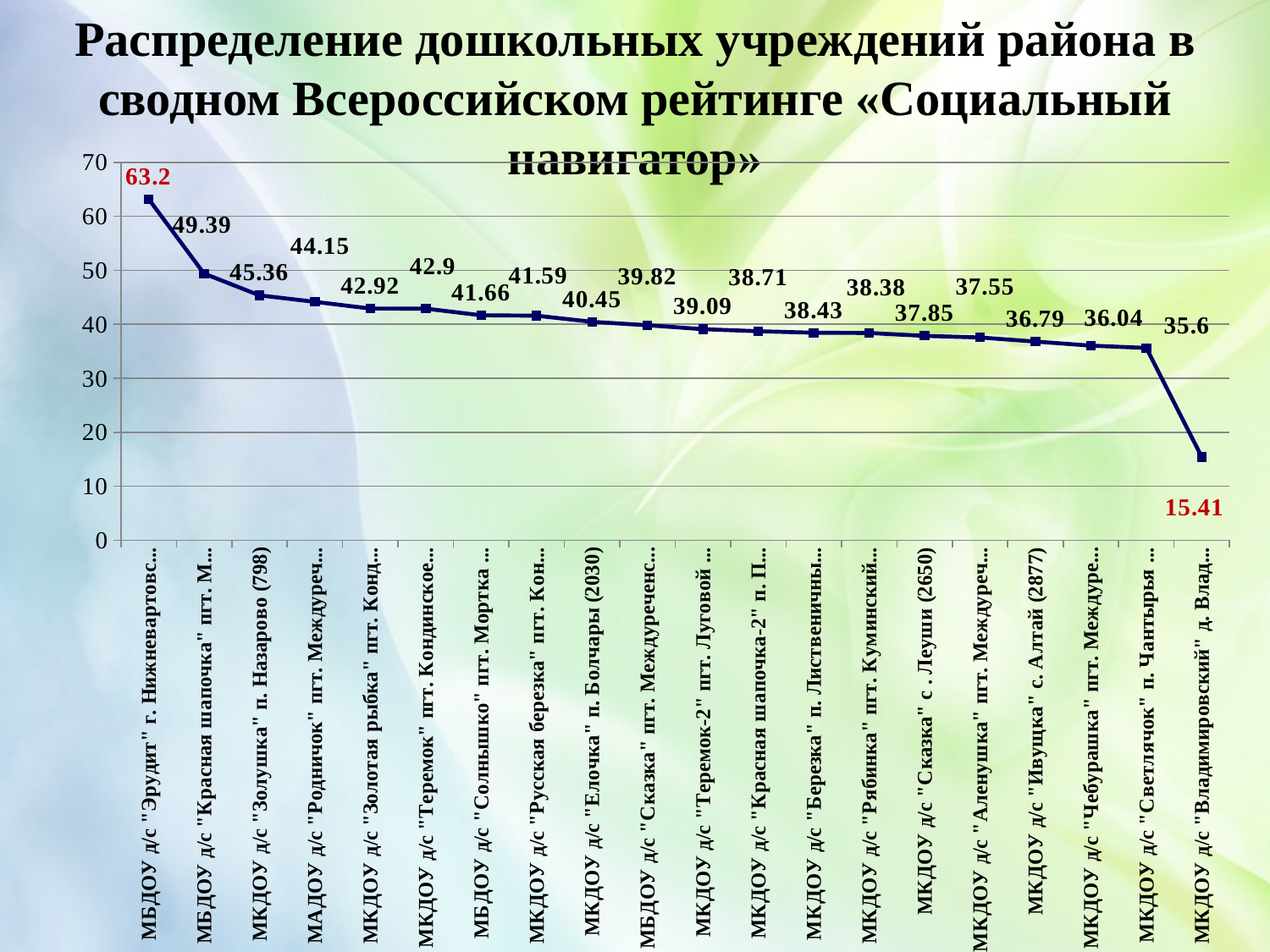
Which has a larger value: МКДОУ д/с "Золушка" п. Назарово (798) or МКДОУ д/с "Ивушка" с. Алтай (2877)? МКДОУ д/с "Золушка" п. Назарово (798) Which institution has the lowest value on the chart? МКДОУ д/с "Владимировский" What type of chart is shown on the slide? line chart How many institutions are plotted on the chart? 20 Which institution has the highest value on the chart? МБДОУ д/с "Эрудит" г. Нижневартовск Do the values generally rise or fall from left to right along the x axis? fall What is the difference between the values for МБДОУ д/с "Красная шапочка" (49.39) and МКДОУ д/с "Золушка" п. Назарово (45.36)? 4.03 What is the value for МКДОУ д/с "Елочка" п. Болчары (2030)? 40.45 What is the value for МКДОУ д/с "Ивушка" с. Алтай (2877)? 36.79 What is the value for МКДОУ д/с "Сказка" с. Леуши (2650)? 37.85 What is the difference between the highest value (63.2) and the lowest value (15.41)? 47.79 What is the value for МКДОУ д/с "Золушка" п. Назарово (798)? 45.36